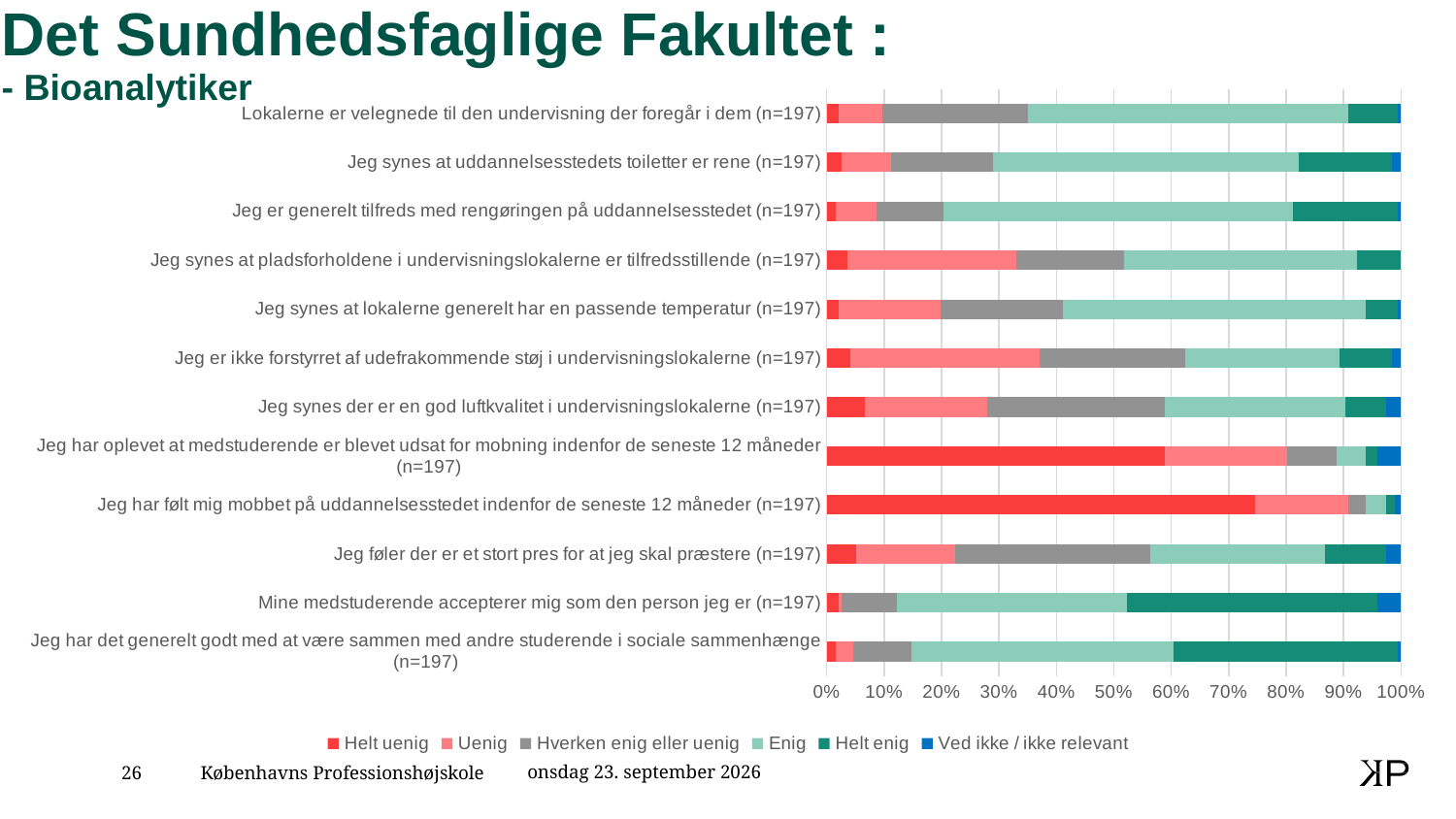
Which has the larger 'Helt uenig' share: 'Jeg har følt mig mobbet på uddannelsesstedet indenfor de seneste 12 måneder' or 'Jeg har oplevet at medstuderende er blevet udsat for mobning indenfor de seneste 12 måneder'? Jeg har følt mig mobbet på uddannelsesstedet indenfor de seneste 12 måneder (n=197) Is the 'Helt uenig' share for 'Jeg har følt mig mobbet på uddannelsesstedet indenfor de seneste 12 måneder' greater or less than 70%? greater What is the first entry in the chart legend? Helt uenig Is the 'Helt uenig' share for 'Jeg har oplevet at medstuderende er blevet udsat for mobning indenfor de seneste 12 måneder' greater or less than 50%? greater What is the sample size (n) shown for each statement in the chart? 197 Is the 'Helt enig' share for 'Jeg har det generelt godt med at være sammen med andre studerende i sociale sammenhænge' greater or less than 30%? greater How many statements (categories) are plotted in the chart? 12 How many series does the legend list? 6 What kind of chart is shown on the slide? Stacked bar chart Which has the larger 'Helt enig' share: 'Mine medstuderende accepterer mig som den person jeg er' or 'Jeg føler der er et stort pres for at jeg skal præstere'? Mine medstuderende accepterer mig som den person jeg er (n=197) Which statement has the largest 'Helt uenig' share? Jeg har følt mig mobbet på uddannelsesstedet indenfor de seneste 12 måneder (n=197)